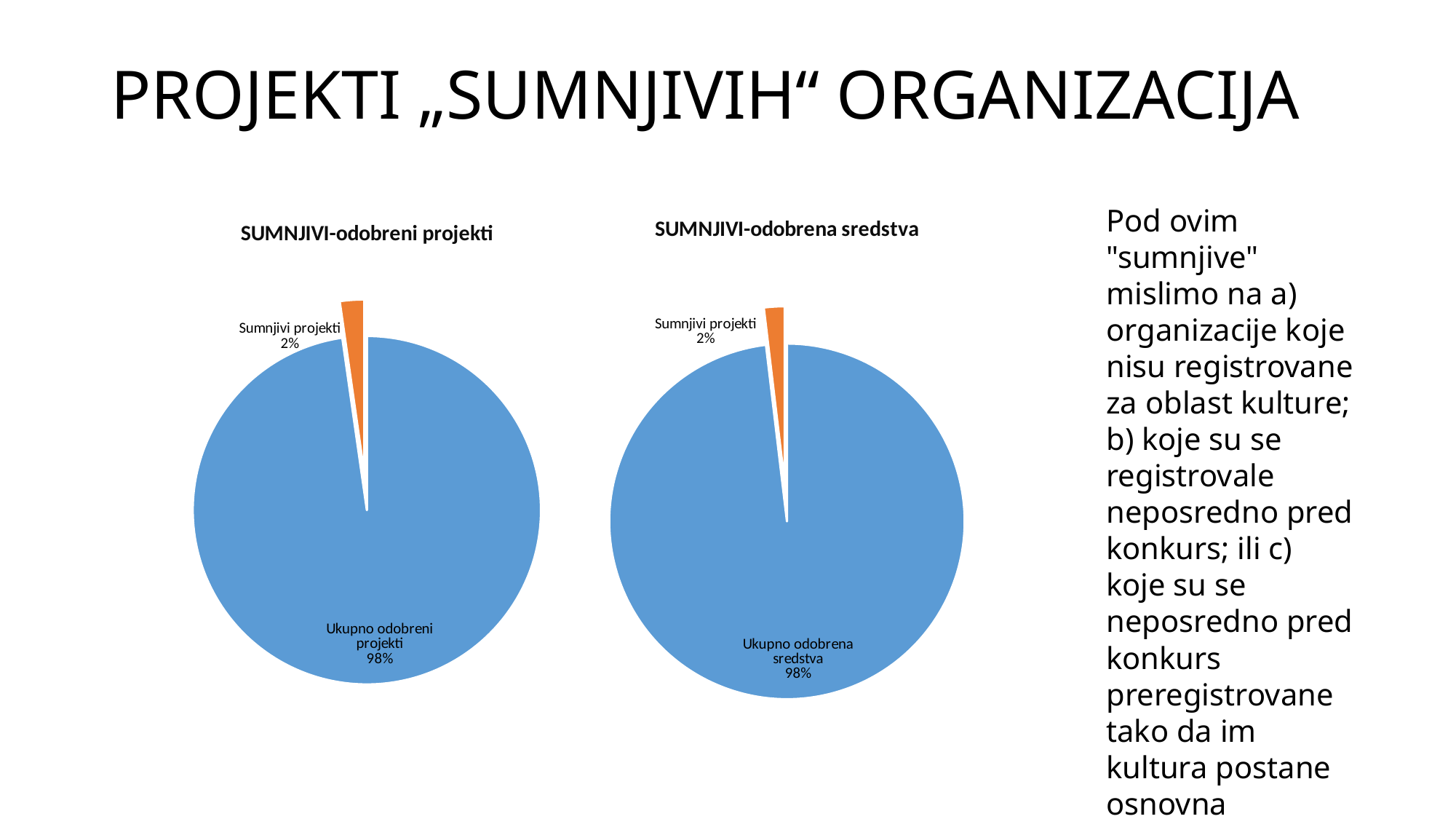
What kind of chart is the left chart, "SUMNJIVI-odobreni projekti"? Pie chart In the chart titled "SUMNJIVI-odobreni projekti", which is larger: "Sumnjivi projekti" or "Ukupno odobreni projekti"? Ukupno odobreni projekti How many slices does the chart titled "SUMNJIVI-odobreni projekti" have? 2 In the chart titled "SUMNJIVI-odobreni projekti", what share of the pie is "Ukupno odobreni projekti"? 98% In the chart titled "SUMNJIVI-odobrena sredstva", which slice is the smallest? Sumnjivi projekti In the chart titled "SUMNJIVI-odobreni projekti", which slice is the largest? Ukupno odobreni projekti In the chart titled "SUMNJIVI-odobrena sredstva", what share of the pie is "Sumnjivi projekti"? 2% In the chart titled "SUMNJIVI-odobrena sredstva", what is the difference in percentage points between "Ukupno odobrena sredstva" and "Sumnjivi projekti"? 96 percentage points In the chart titled "SUMNJIVI-odobrena sredstva", what share of the pie is "Ukupno odobrena sredstva"? 98% What colour is the "Sumnjivi projekti" slice in the chart titled "SUMNJIVI-odobrena sredstva"? Orange What kind of chart is the right chart, "SUMNJIVI-odobrena sredstva"? Pie chart